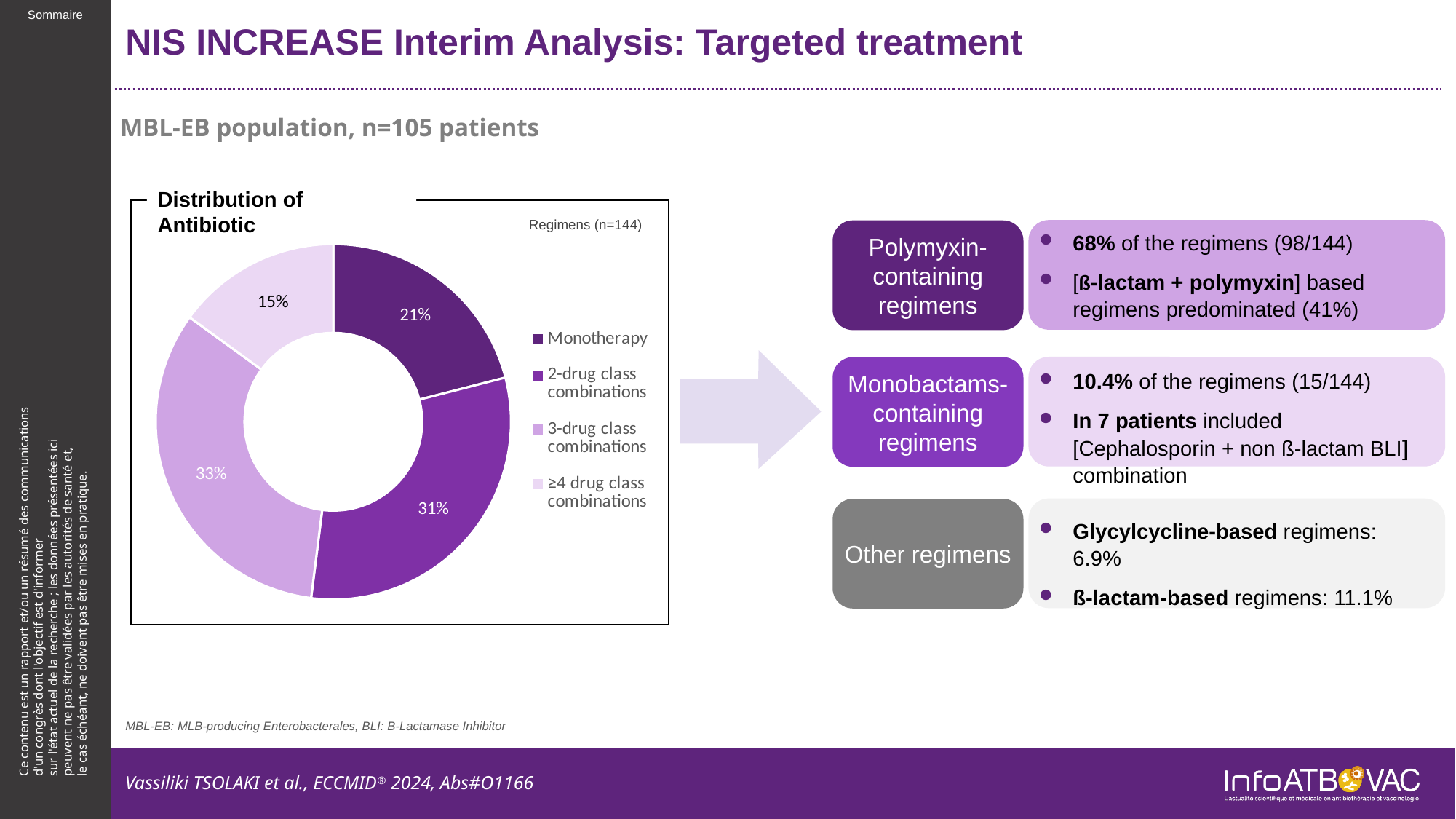
What share of regimens is Monotherapy in the Distribution of Antibiotic chart? 21% What kind of chart is used to show the Distribution of Antibiotic regimens? Donut (pie) chart How many regimens does the chart state it is based on (n)? 144 What share of regimens is 2-drug class combinations? 31% How many categories are shown in the donut chart? 4 Which category has the smallest share in the donut chart? ≥4 drug class combinations What share of regimens is ≥4 drug class combinations? 15% What is the difference in percentage points between Monotherapy and ≥4 drug class combinations? 6 percentage points Which is larger: the share for Monotherapy or the share for 2-drug class combinations? 2-drug class combinations What share of regimens is 3-drug class combinations? 33% Which category has the largest share in the donut chart? 3-drug class combinations What is the combined share of 2-drug and 3-drug class combinations? 64%